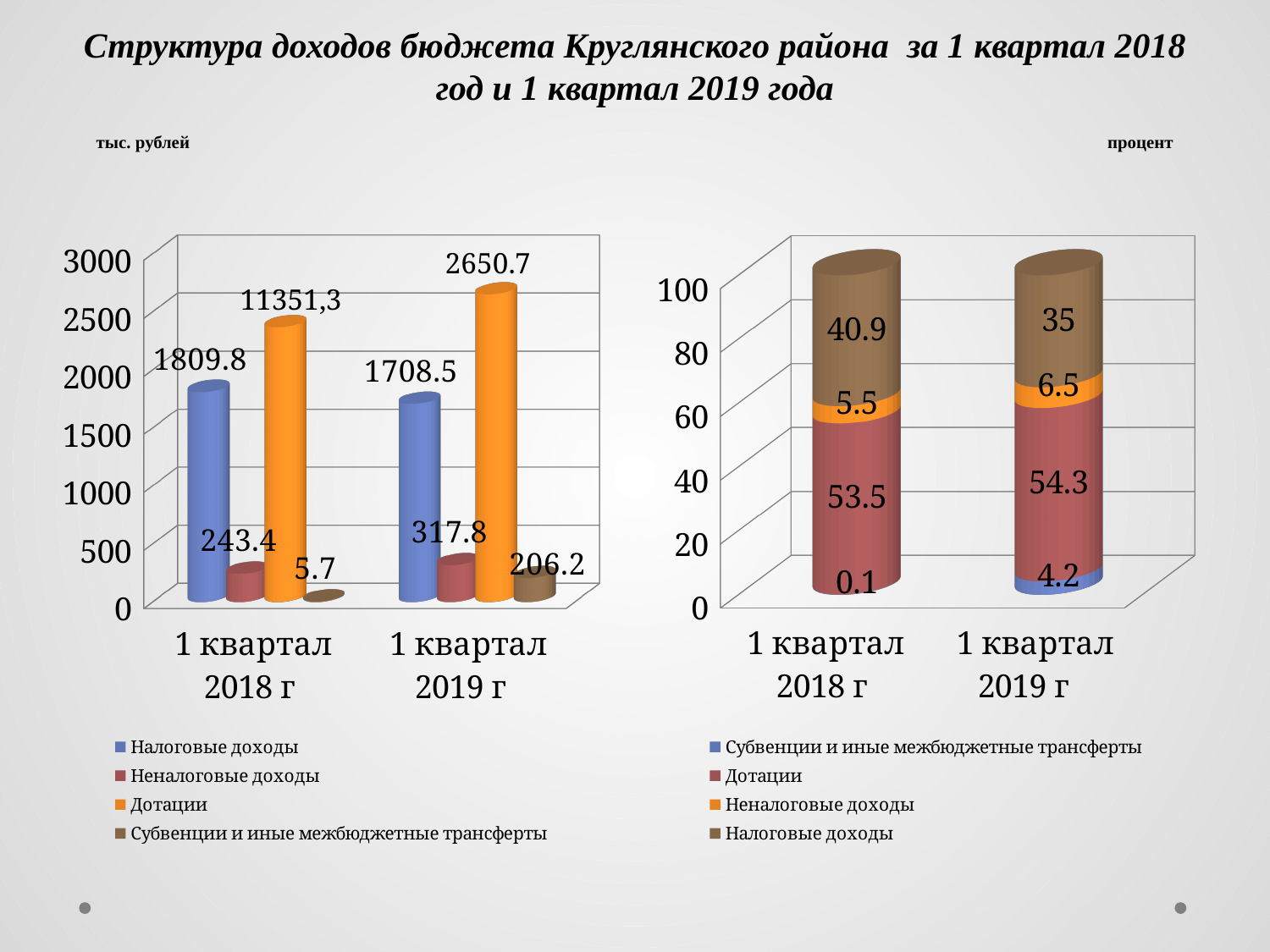
On the right chart (процент), what is the share of Дотации for 1 квартал 2019 г? 54.3 On the right chart (процент), what is the difference between Налоговые доходы in 1 квартал 2018 г and 1 квартал 2019 г? 5.9 What kind of chart is the right chart (процент)? Stacked bar chart On the right chart (процент), what is the value of Налоговые доходы for 1 квартал 2018 г? 40.9 On the left chart (тыс. рублей), what is the difference between Неналоговые доходы in 1 квартал 2019 г and 1 квартал 2018 г? 74.4 On the left chart (тыс. рублей), what is the value of Субвенции и иные межбюджетные трансферты for 1 квартал 2019 г? 206.2 On the right chart (процент), what is the value of Субвенции и иные межбюджетные трансферты for 1 квартал 2019 г? 4.2 On the left chart (тыс. рублей), how many series does the legend list? 4 On the left chart (тыс. рублей), what is the value of Дотации for 1 квартал 2019 г? 2650.7 On the right chart (процент), which segment is the smallest in 1 квартал 2018 г? Субвенции и иные межбюджетные трансферты On the left chart (тыс. рублей), what is the value of Налоговые доходы for 1 квартал 2018 г? 1809.8 On the left chart (тыс. рублей), which is larger: Налоговые доходы in 1 квартал 2018 г or in 1 квартал 2019 г? 1 квартал 2018 г